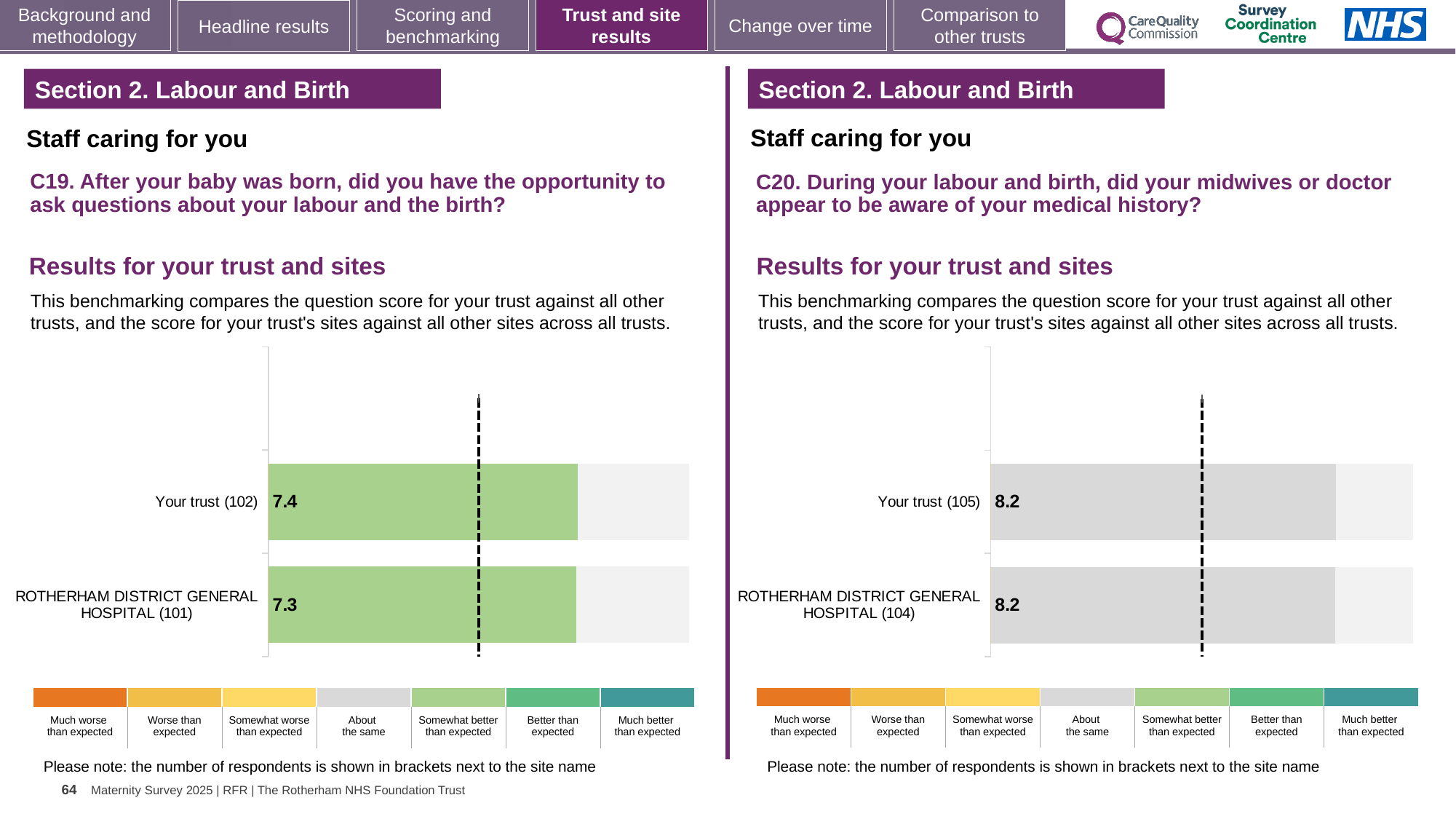
How many bars are plotted in the C20 chart on the right? 2 In the C20 chart on the right, what is the score for Your trust (105)? 8.2 In the C19 chart on the left, what is the score for Your trust (102)? 7.4 In the C20 chart on the right, what is the difference between the score for Your trust and the score for ROTHERHAM DISTRICT GENERAL HOSPITAL? 0 In the C19 chart on the left, what is the difference between the score for Your trust and the score for ROTHERHAM DISTRICT GENERAL HOSPITAL? 0.1 In the C20 chart on the right, what is the score for ROTHERHAM DISTRICT GENERAL HOSPITAL (104)? 8.2 In the C19 chart on the left, which has the higher score: Your trust or ROTHERHAM DISTRICT GENERAL HOSPITAL? Your trust In the C19 chart on the left, which benchmark category does the colour of the Your trust bar correspond to? Somewhat better than expected In the C20 chart on the right, which benchmark category does the colour of the Your trust bar correspond to? About the same How many bars are plotted in the C19 chart on the left? 2 What type of chart is used in the C19 chart on the left? Bar chart In the C19 chart on the left, what is the score for ROTHERHAM DISTRICT GENERAL HOSPITAL (101)? 7.3